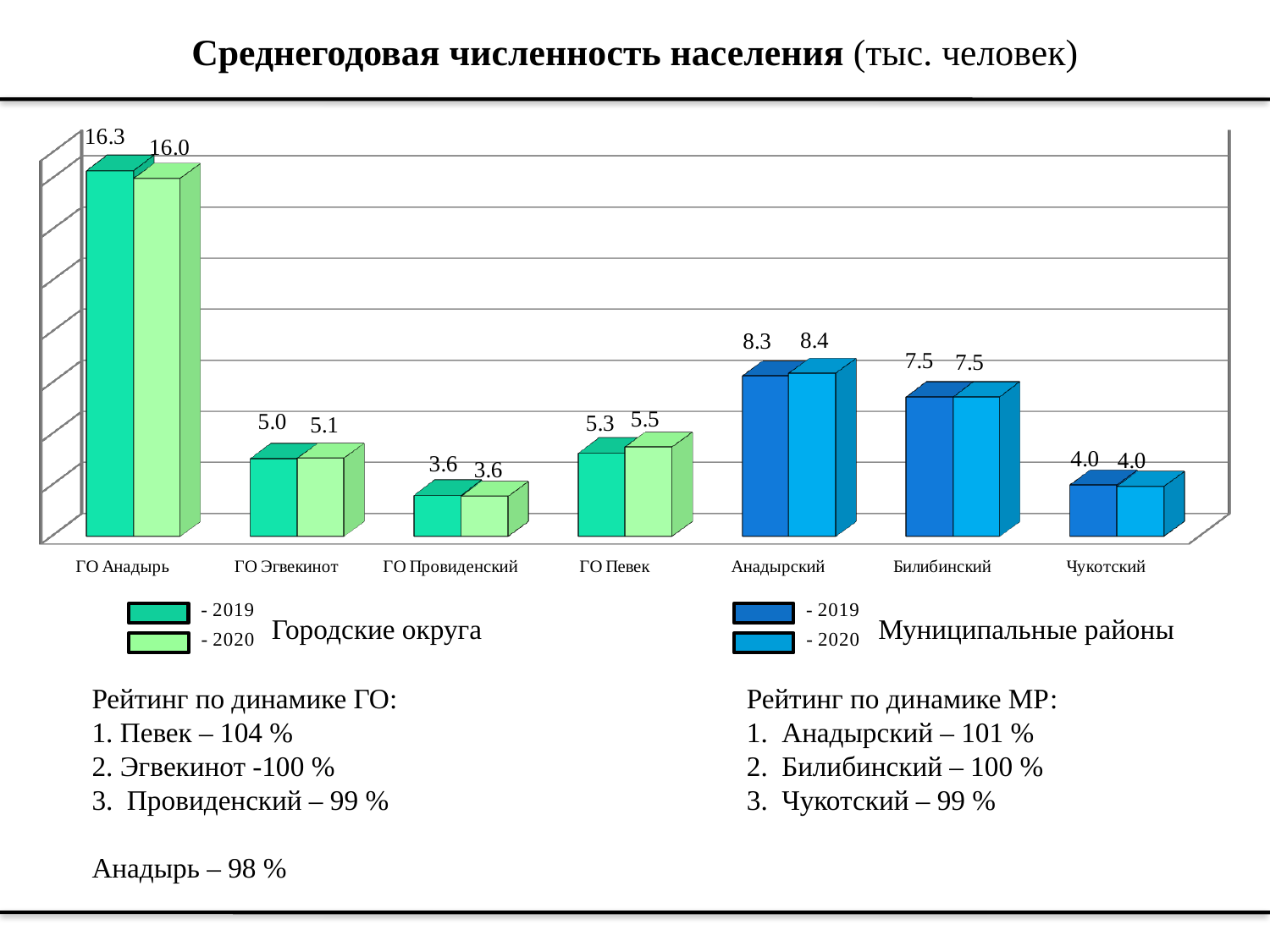
What was the average annual population of ГО Анадырь in 2019, according to the chart? 16.3 Which category has the highest population in the chart? ГО Анадырь Which two years are compared in the chart's legend? 2019 and 2020 What is the 2020 value for ГО Певек? 5.5 What is the difference between the 2020 values of Анадырский and Билибинский? 0.9 What is the title of the chart? Среднегодовая численность населения (тыс. человек) Which category has the lowest population in 2019? ГО Провиденский By how much did the population of ГО Анадырь change from 2019 to 2020? 0.3 How many categories (territories) are shown on the x axis of the chart? 7 Which is larger: the 2019 value for ГО Певек or the 2019 value for ГО Эгвекинот? ГО Певек What type of chart is shown on the slide? Bar chart What value does the chart show for Анадырский in 2020? 8.4